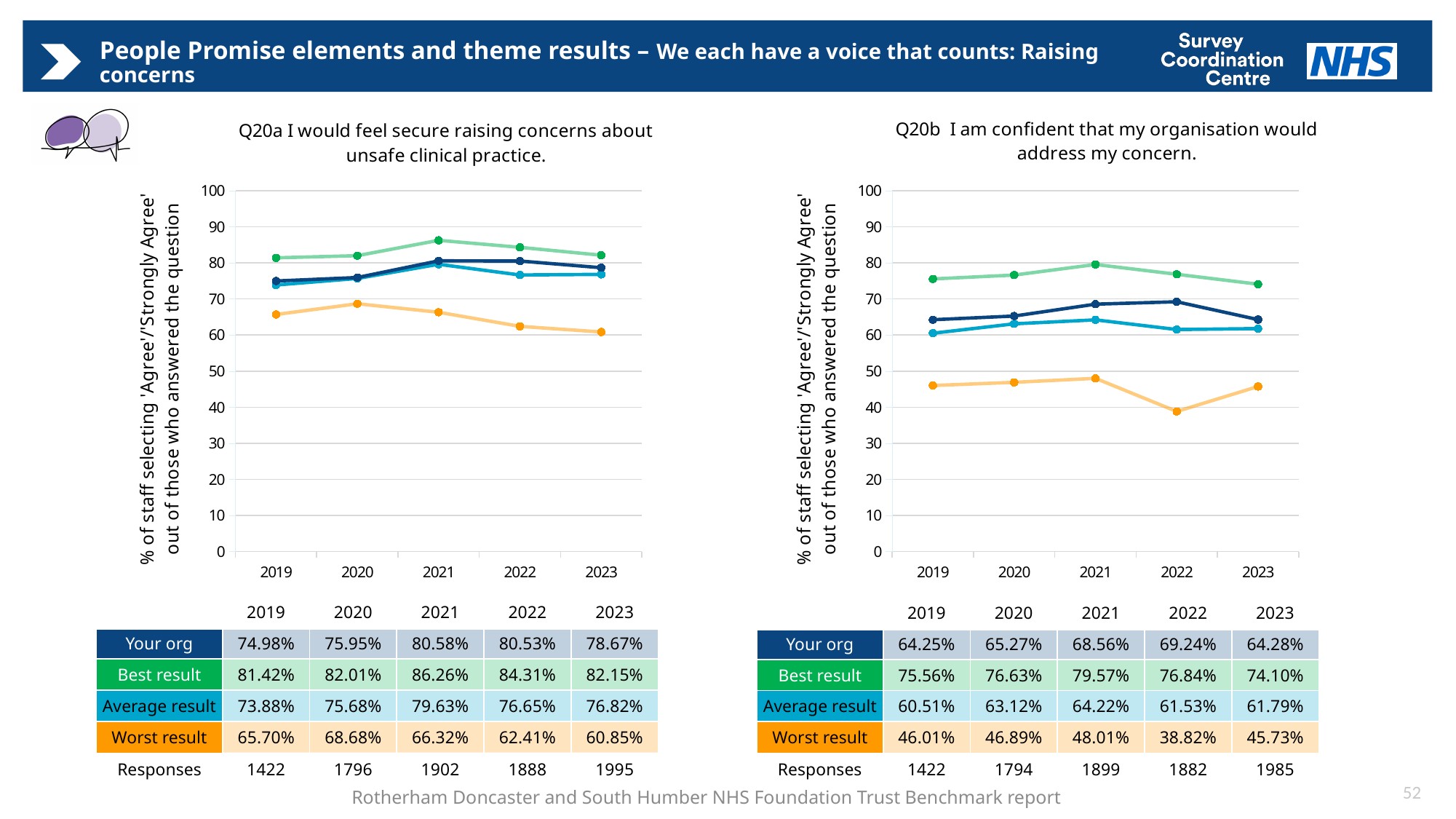
In the Q20b chart, in which year was the 'Your org' value lowest? 2019 In the Q20a chart, what is the difference between the 'Best result' and 'Your org' values in 2023? 3.48% What type of chart is used for Q20a? Line chart In the Q20b chart, what was the 'Worst result' value in 2022? 38.82% How many years are plotted on the x axis of the Q20a chart? 5 In the Q20a chart, does the 'Worst result' line rise or fall from 2020 to 2023? Fall In the Q20b chart, which is larger in 2020: 'Your org' or 'Average result'? Your org How many series are plotted in the Q20b chart? 4 In the Q20b chart, is the 'Worst result' value for 2022 greater or less than 40? less In the Q20b chart, what colour is the 'Best result' line? Green In the Q20a chart, in which year was the 'Best result' highest? 2021 In the Q20a chart, what was the 'Your org' value in 2021? 80.58%